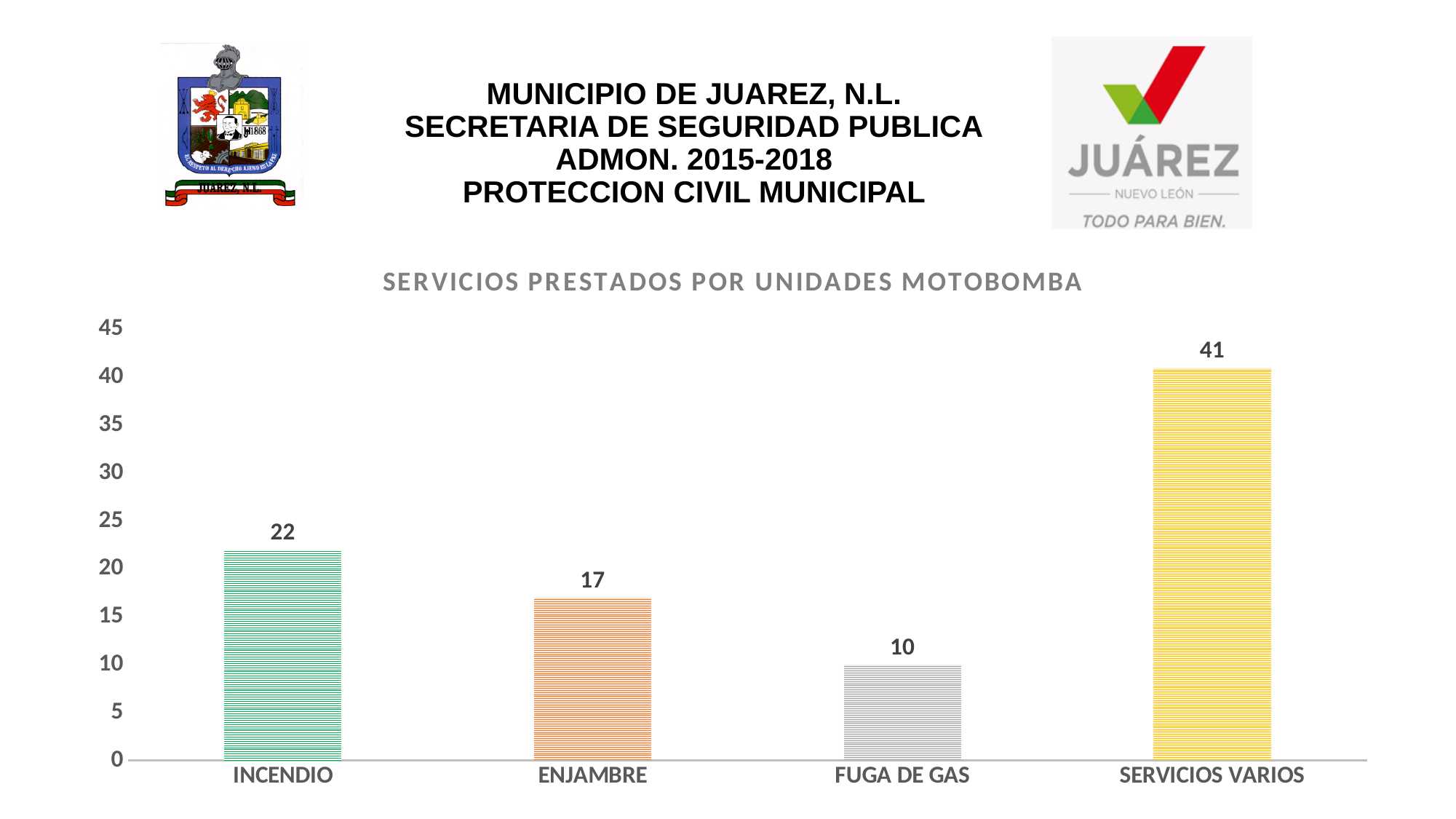
What is the difference between the values for SERVICIOS VARIOS and INCENDIO? 19 What is the value for ENJAMBRE? 17 What is the value for INCENDIO? 22 What is the value for SERVICIOS VARIOS? 41 Which is larger, the value for ENJAMBRE or the value for FUGA DE GAS? ENJAMBRE Which category has the highest value? SERVICIOS VARIOS What is the difference between the values for INCENDIO and ENJAMBRE? 5 How many categories are shown in the chart? 4 Which category has the lowest value? FUGA DE GAS What is the value for FUGA DE GAS? 10 What is the title of the chart? SERVICIOS PRESTADOS POR UNIDADES MOTOBOMBA What kind of chart is shown on the slide? bar chart